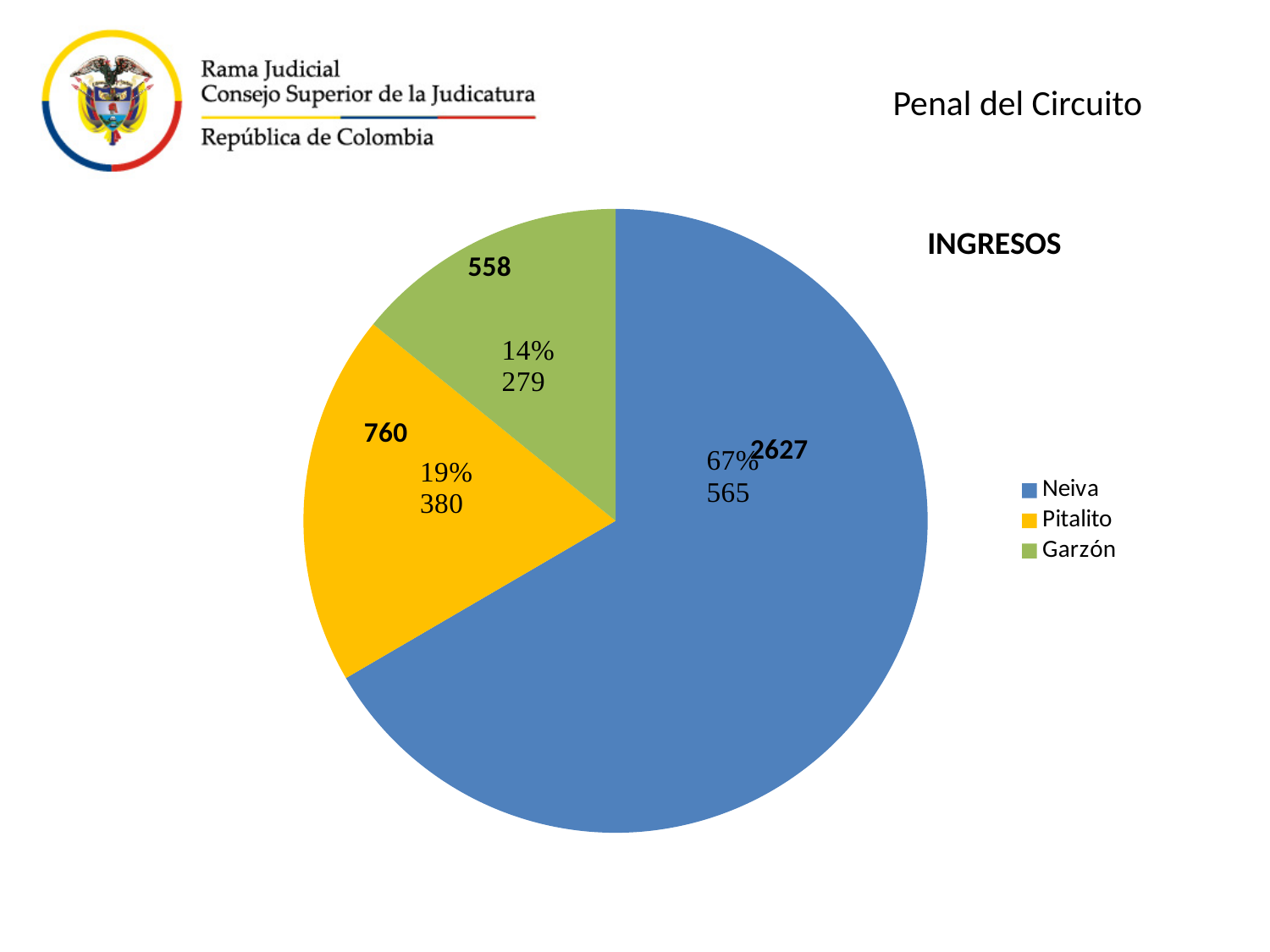
Which category has the largest slice of the pie? Neiva What is the value shown for Pitalito? 760 What is the difference between the values for Neiva and Pitalito? 1867 What kind of chart is shown on the slide? pie chart How many slices does the pie chart have? 3 What is the value shown for Neiva? 2627 What is the value shown for Garzón? 558 How many entries does the legend list? 3 What is the title of the chart? INGRESOS Which category has the smallest slice of the pie? Garzón What percentage share of the pie does Neiva have? 67% Which colour represents Pitalito in the pie chart? yellow